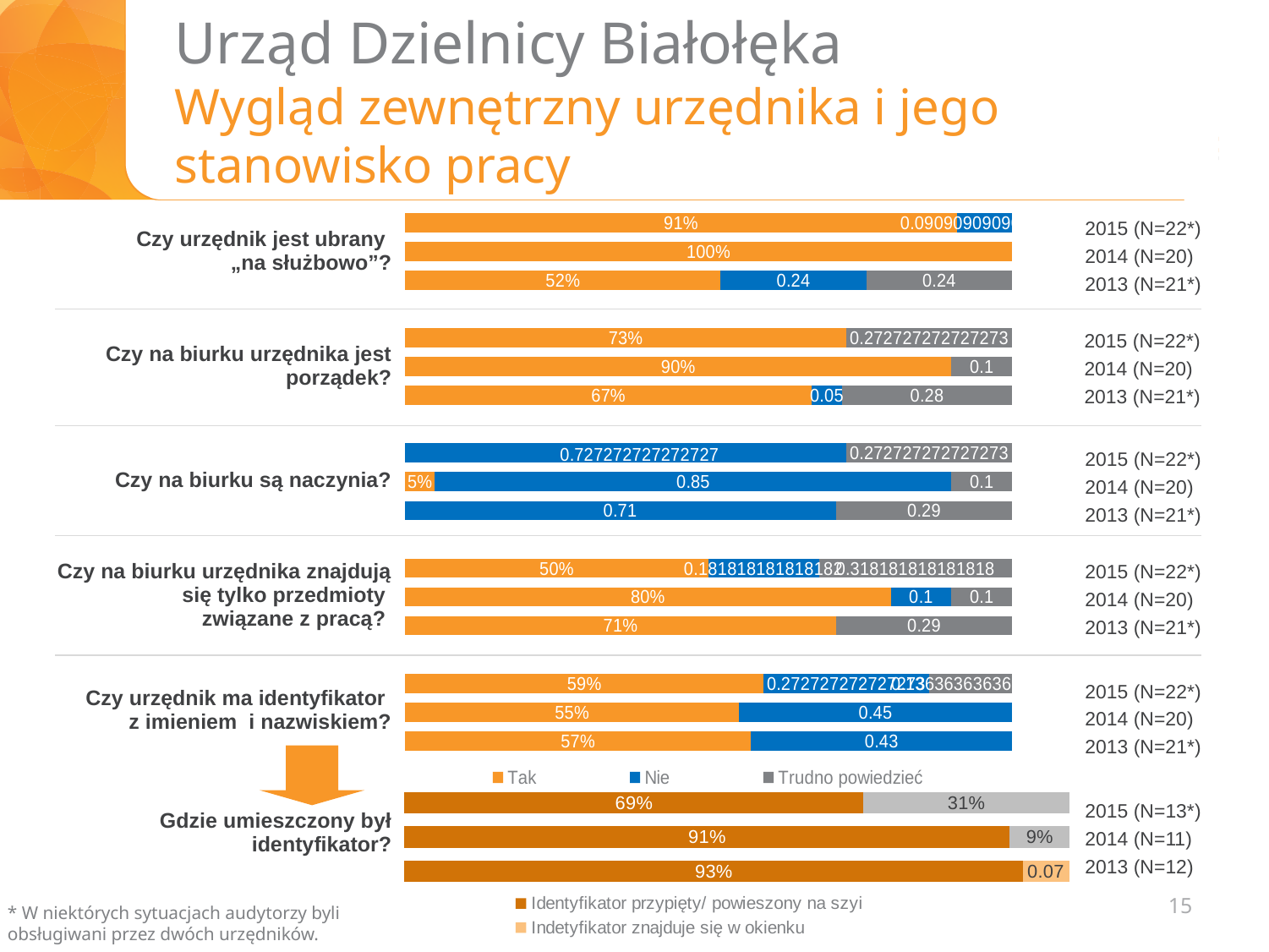
In the chart "Czy urzędnik jest ubrany „na służbowo”?", what is the "Tak" value for 2014 (N=20)? 100% In the chart "Gdzie umieszczony był identyfikator?", which year has the lowest value for "Identyfikator przypięty/ powieszony na szyi"? 2015 (N=13*) In the chart "Czy na biurku urzędnika jest porządek?", what is the "Trudno powiedzieć" value for 2013 (N=21*)? 0.28 How many series does the legend list for the chart "Czy urzędnik ma identyfikator z imieniem i nazwiskiem?"? 3 In the chart "Czy na biurku urzędnika jest porządek?", which year has the highest "Tak" value? 2014 (N=20) In the chart "Czy na biurku są naczynia?", what is the "Nie" value for 2014 (N=20)? 0.85 In the chart "Gdzie umieszczony był identyfikator?", what is the value for "Identyfikator przypięty/ powieszony na szyi" in 2015 (N=13*)? 69% In the chart "Czy na biurku są naczynia?", what is the "Tak" value for 2014 (N=20)? 5% In the chart "Czy urzędnik jest ubrany „na służbowo”?", what is the "Tak" value for 2013 (N=21*)? 52% In the chart "Czy na biurku urzędnika znajdują się tylko przedmioty związane z pracą?", what is the difference between the "Tak" values for 2014 (N=20) and 2015 (N=22*)? 30 percentage points In the chart "Czy urzędnik ma identyfikator z imieniem i nazwiskiem?", what is the "Nie" value for 2014 (N=20)? 0.45 In the chart "Czy urzędnik ma identyfikator z imieniem i nazwiskiem?", which is larger: the "Tak" value for 2015 (N=22*) or for 2013 (N=21*)? 2015 (N=22*)